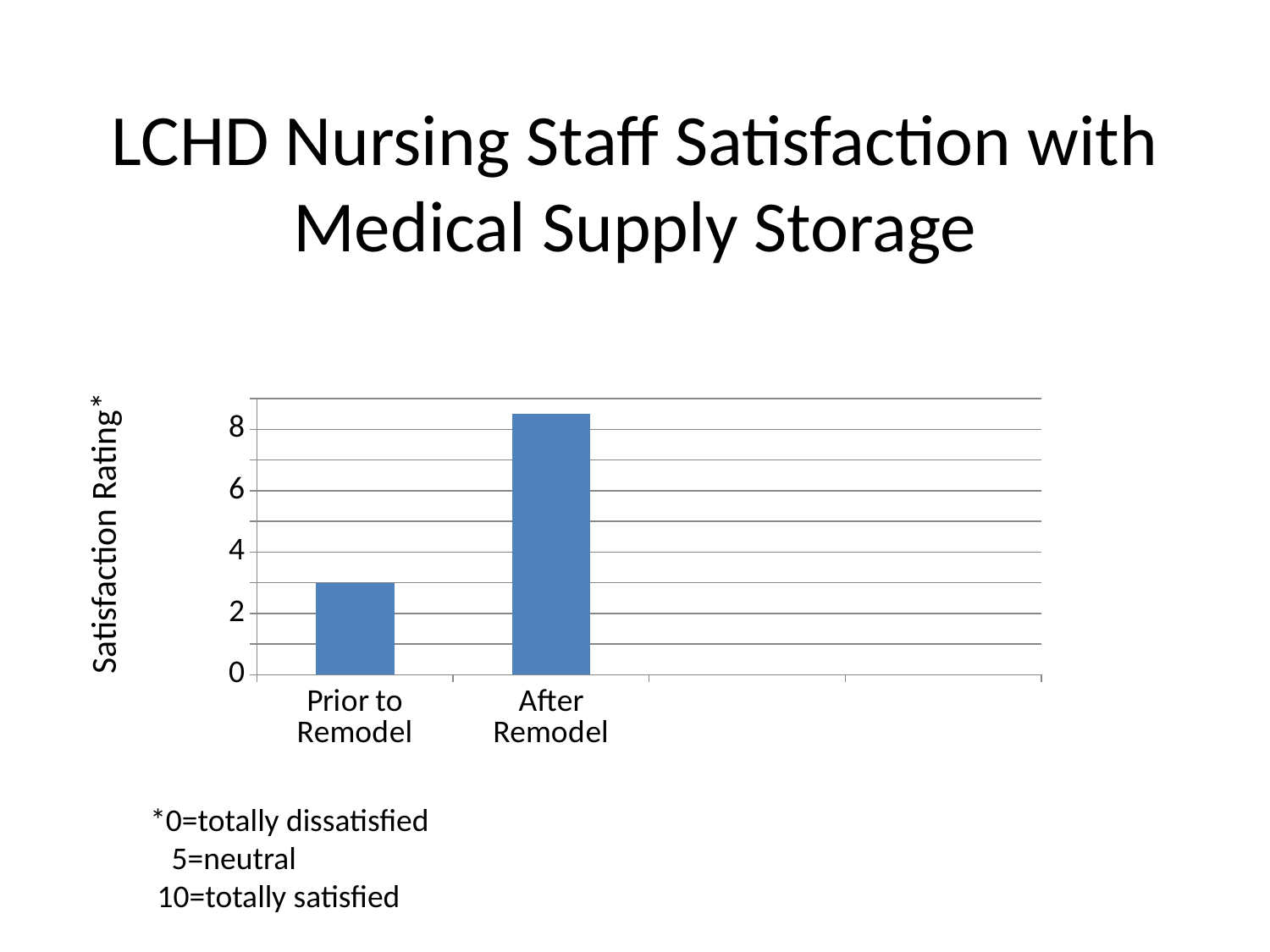
Is the satisfaction rating for Prior to Remodel greater or less than 4? less Is the satisfaction rating for Prior to Remodel greater or less than 2? greater Which category has the highest satisfaction rating? After Remodel Is the satisfaction rating for After Remodel greater or less than 6? greater According to the footnote, what rating value means neutral? 5 Which is larger, the satisfaction rating Prior to Remodel or After Remodel? After Remodel How many categories are plotted on the x axis? 2 Which category has the lowest satisfaction rating? Prior to Remodel What kind of chart is shown on the slide? bar chart Does the satisfaction rating rise or fall from Prior to Remodel to After Remodel? rise What is the label on the y axis of the chart? Satisfaction Rating*